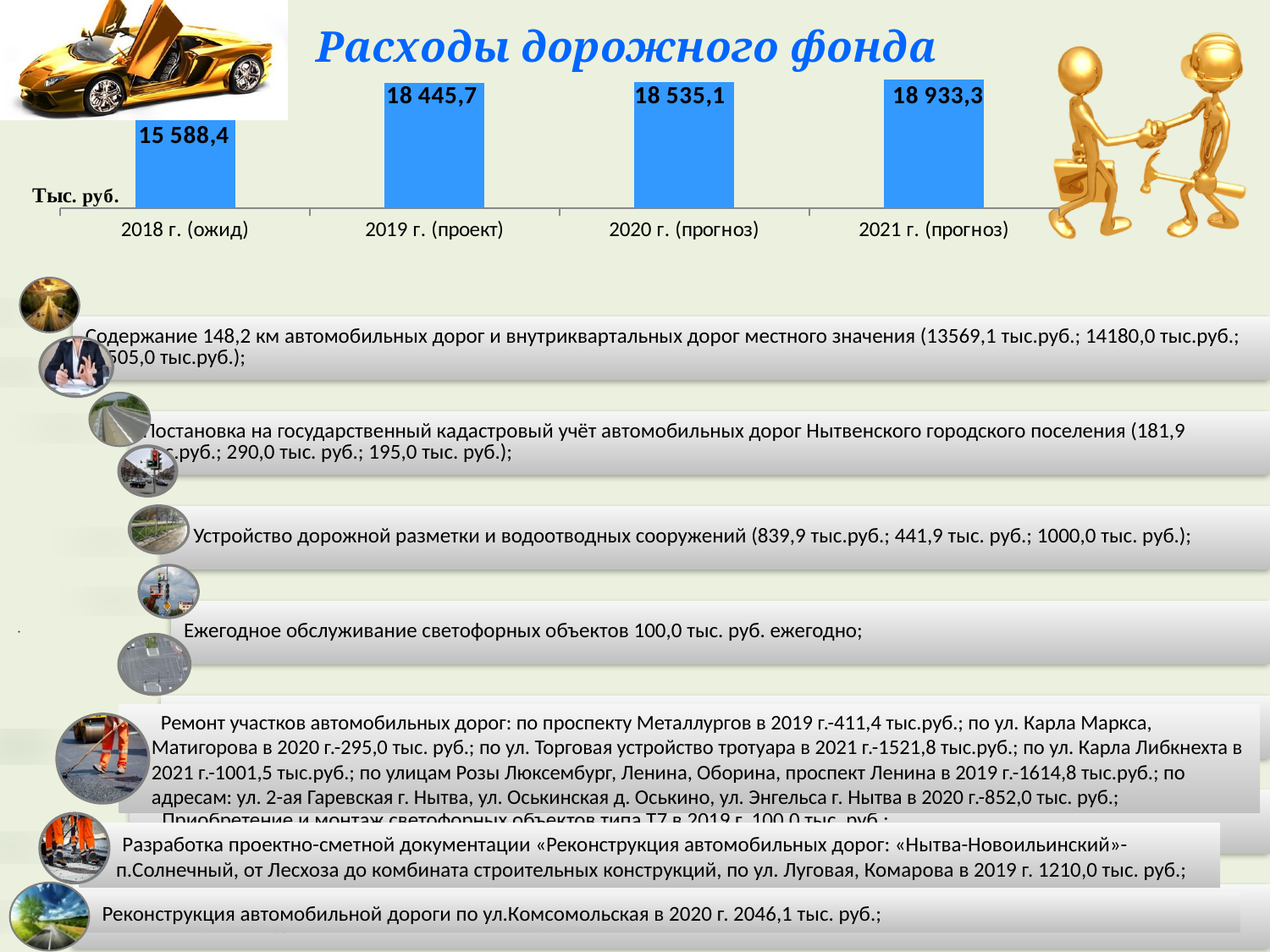
What is the value for 2019 г. (проект) in the chart? 18 445,7 What is the difference between the values for 2019 г. (проект) and 2018 г. (ожид)? 2 857,3 Which is larger, the value for 2019 г. (проект) or the value for 2018 г. (ожид)? 2019 г. (проект) Which year has the lowest value in the chart? 2018 г. (ожид) Do the values rise or fall from 2018 to 2021 along the x axis? Rise What kind of chart is shown on the slide? Bar chart What is the difference between the values for 2021 г. (прогноз) and 2018 г. (ожид)? 3 344,9 What is the value for 2018 г. (ожид) in the chart? 15 588,4 What is the value for 2020 г. (прогноз) in the chart? 18 535,1 How many years (categories) are shown in the chart? 4 Which year has the highest value in the chart? 2021 г. (прогноз) What is the value for 2021 г. (прогноз) in the chart? 18 933,3